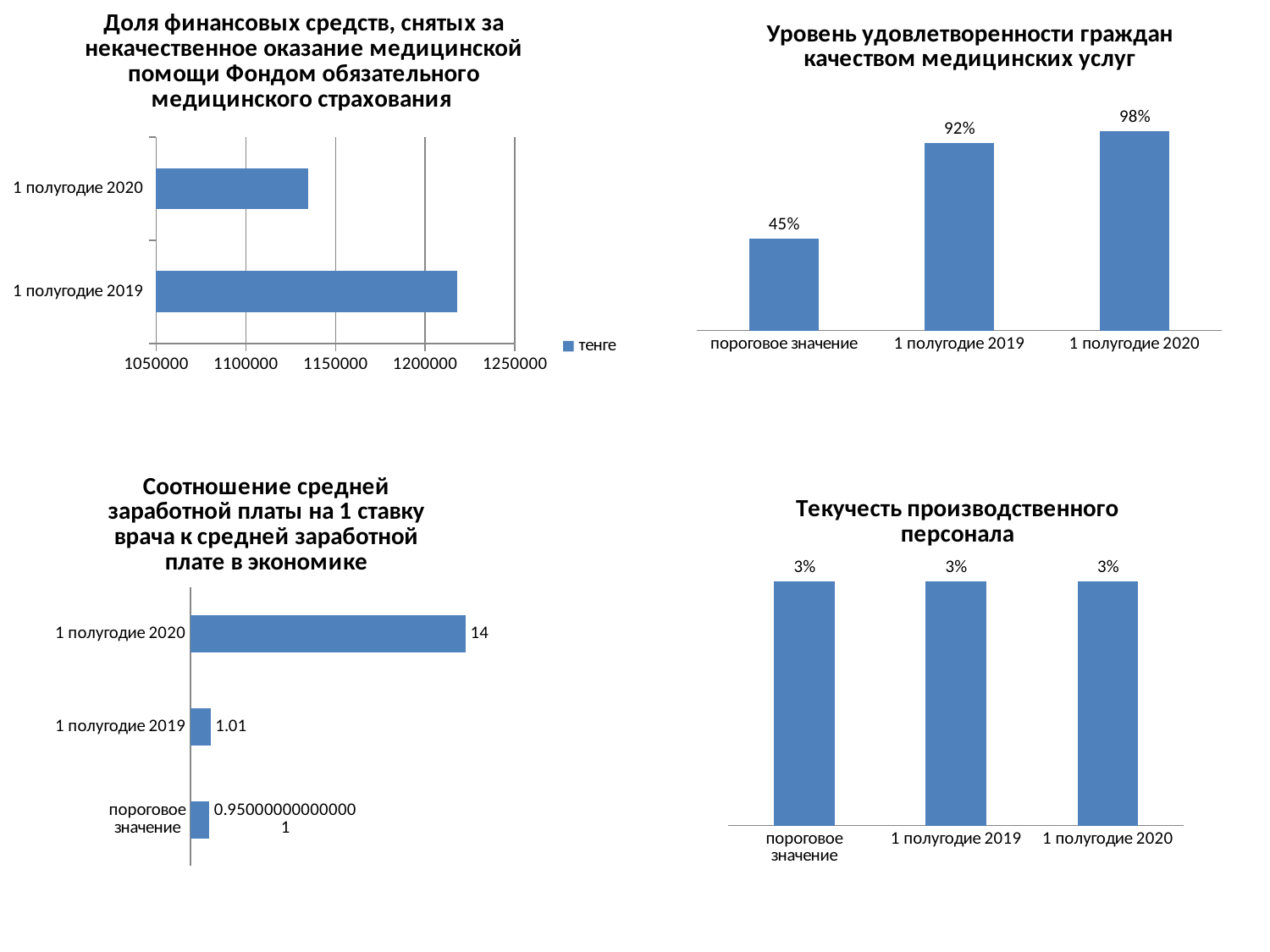
In the chart 'Уровень удовлетворенности граждан качеством медицинских услуг', what is the value for пороговое значение? 45% In the chart 'Уровень удовлетворенности граждан качеством медицинских услуг', what is the difference between 1 полугодие 2020 and 1 полугодие 2019? 6% In the chart 'Соотношение средней заработной платы на 1 ставку врача к средней заработной плате в экономике', which category has the highest value? 1 полугодие 2020 In the chart 'Уровень удовлетворенности граждан качеством медицинских услуг', which category has the lowest value? пороговое значение In the chart 'Текучесть производственного персонала', what is the value for 1 полугодие 2019? 3% In the chart 'Уровень удовлетворенности граждан качеством медицинских услуг', what is the value for 1 полугодие 2020? 98% In the chart 'Соотношение средней заработной платы на 1 ставку врача к средней заработной плате в экономике', how many categories are shown? 3 In the top-left chart, what is the legend entry? тенге In the chart 'Доля финансовых средств, снятых за некачественное оказание медицинской помощи Фондом обязательного медицинского страхования', which of the two categories has the larger value, 1 полугодие 2019 or 1 полугодие 2020? 1 полугодие 2019 What type of chart is the top-left chart on the slide? bar chart In the chart 'Соотношение средней заработной платы на 1 ставку врача к средней заработной плате в экономике', what is the value for 1 полугодие 2019? 1.01 In the chart 'Доля финансовых средств, снятых за некачественное оказание медицинской помощи Фондом обязательного медицинского страхования', is the value for 1 полугодие 2019 greater or less than 1200000? greater